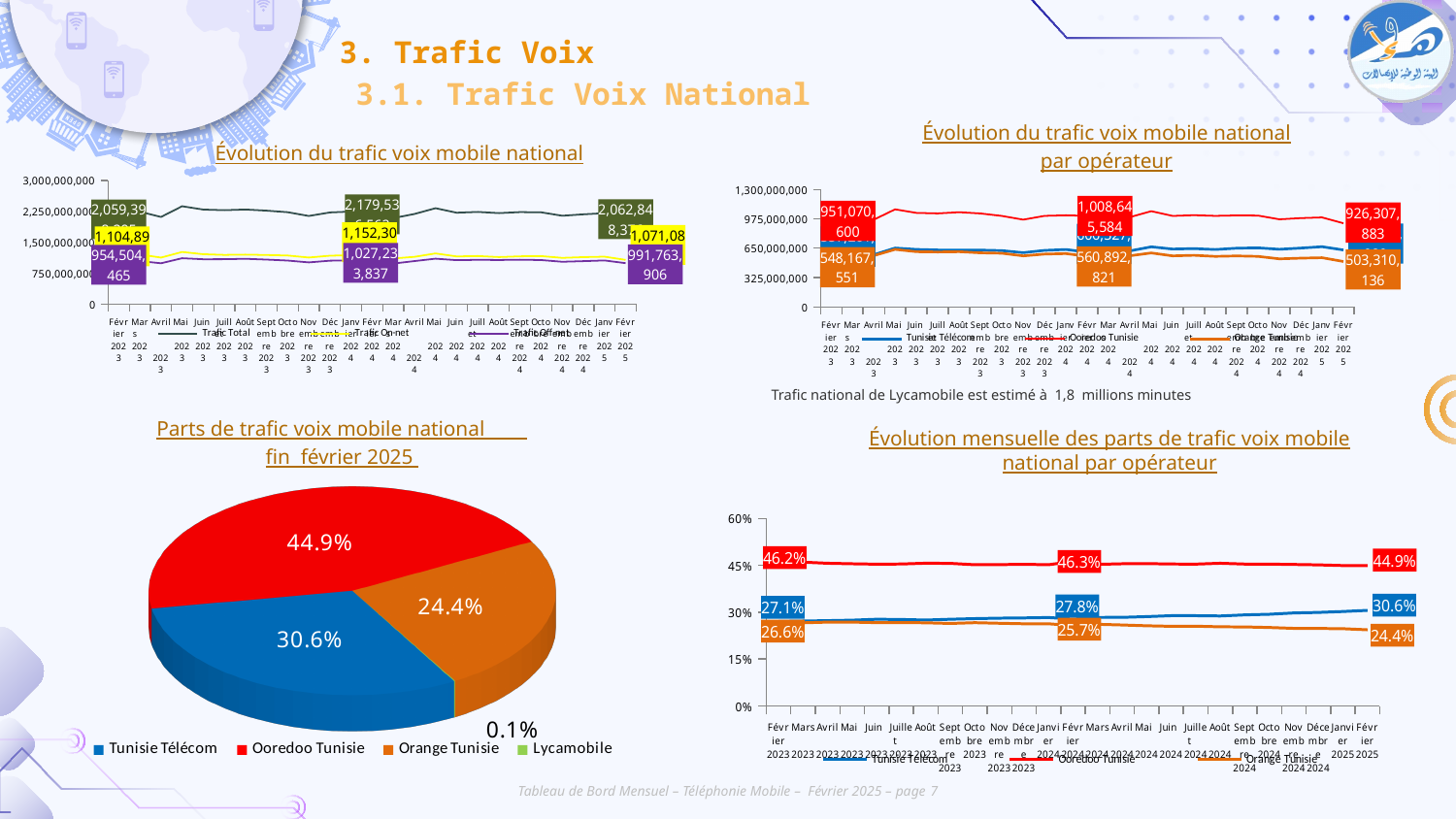
In the chart 'Évolution mensuelle des parts de trafic voix mobile national par opérateur', does Tunisie Telecom's share rise or fall between February 2023 and February 2025? rise In the pie chart 'Parts de trafic voix mobile national fin février 2025', which operator has the smallest share? Lycamobile In the chart 'Évolution du trafic voix mobile national par opérateur', what is the value labelled for Orange Tunisie in February 2024? 560,892,821 In the pie chart 'Parts de trafic voix mobile national fin février 2025', what is the difference between the shares of Tunisie Télécom and Orange Tunisie? 6.2% What kind of chart is 'Évolution du trafic voix mobile national par opérateur'? line chart In the pie chart 'Parts de trafic voix mobile national fin février 2025', which operator has the largest share? Ooredoo Tunisie In the chart 'Évolution mensuelle des parts de trafic voix mobile national par opérateur', what was Ooredoo Tunisie's share in February 2023? 46.2% In the chart 'Évolution du trafic voix mobile national par opérateur', what is the value labelled for Ooredoo Tunisie in February 2025? 926,307,883 In the pie chart 'Parts de trafic voix mobile national fin février 2025', how many operators does the legend list? 4 In the pie chart 'Parts de trafic voix mobile national fin février 2025', what share does Tunisie Télécom hold? 30.6% In the chart 'Évolution mensuelle des parts de trafic voix mobile national par opérateur', what was Orange Tunisie's share in February 2024? 25.7% In the pie chart 'Parts de trafic voix mobile national fin février 2025', what share does Ooredoo Tunisie hold? 44.9%